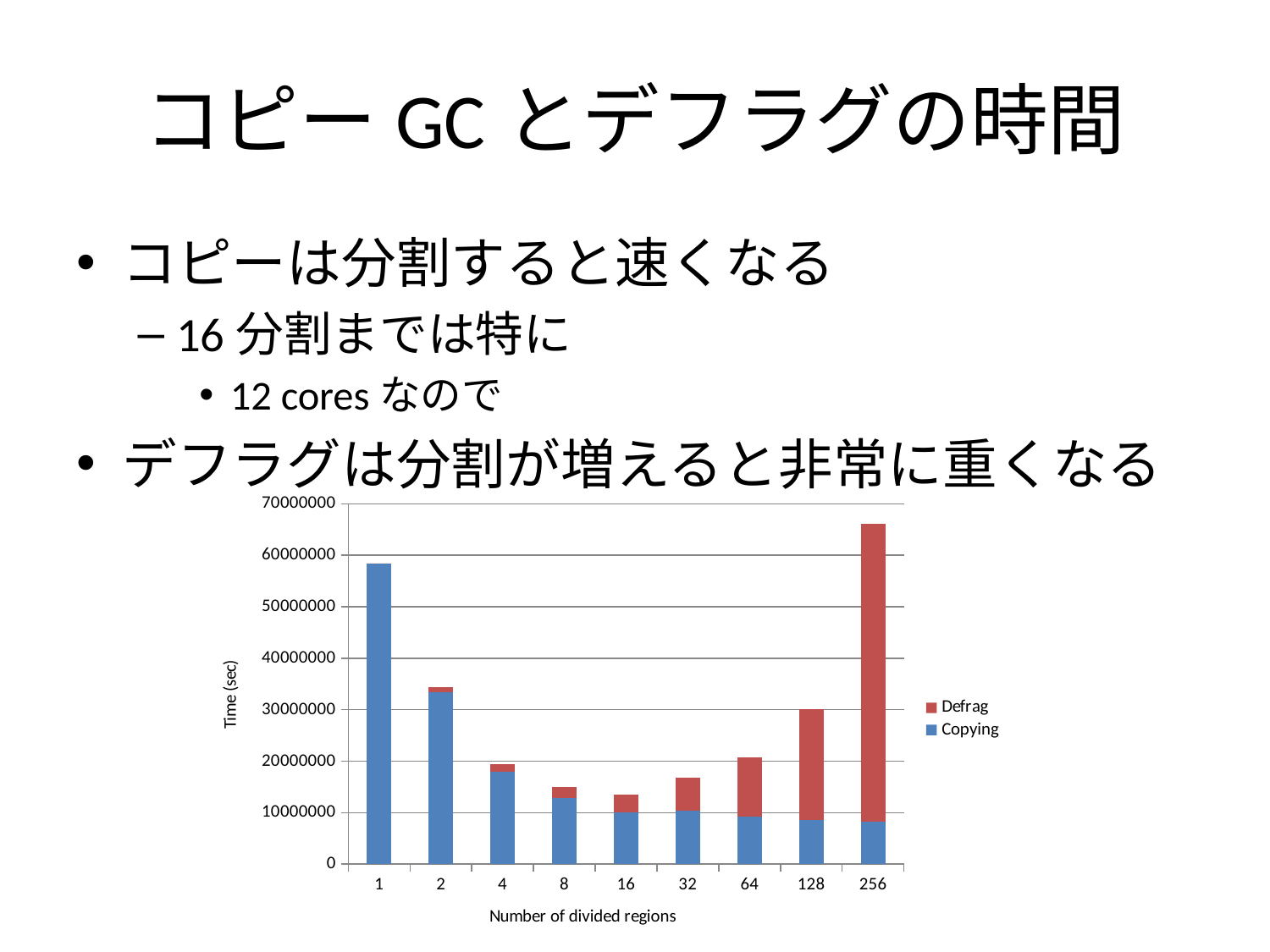
Which number of divided regions has the tallest total bar? 256 Is the total bar for 1 divided region greater or less than 50000000? greater Is the total bar for 16 divided regions greater or less than 20000000? less Which has a larger Defrag value: 128 divided regions or 256 divided regions? 256 Is the Copying value for 256 divided regions greater or less than 10000000? less What is the title of the x axis of the chart? Number of divided regions How many series does the chart legend list? 2 What kind of chart is shown on the slide? Stacked bar chart How many categories are shown on the x axis of the chart? 9 Which has a larger Copying value: 1 divided region or 2 divided regions? 1 Does the Copying value rise or fall as the number of divided regions increases along the x axis? fall